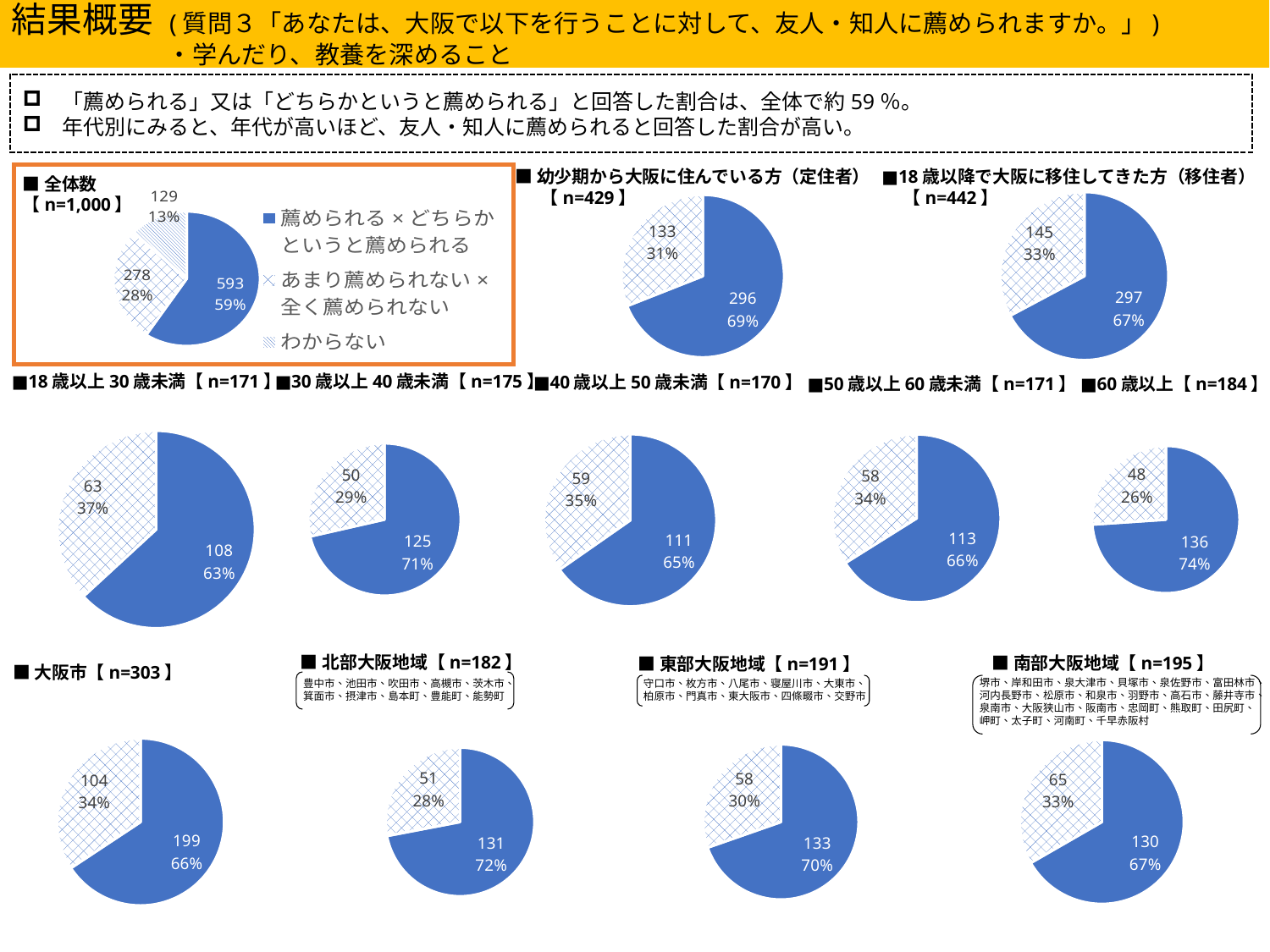
Which has a larger solid blue percentage: the 北部大阪地域【n=182】 pie chart or the 南部大阪地域【n=195】 pie chart? 北部大阪地域【n=182】 In the 30歳以上40歳未満【n=175】 pie chart, what is the count shown for the solid blue slice? 125 In the 全体数【n=1,000】 pie chart, what percentage share is shown for わからない? 13% What type of chart is used for the 全体数【n=1,000】 data? Pie chart Among the five age-group pie charts, which group shows the highest percentage for the solid blue slice? 60歳以上【n=184】 Among the five age-group pie charts, which group shows the lowest percentage for the solid blue slice? 18歳以上30歳未満【n=171】 In the 全体数【n=1,000】 pie chart, what is the count for 薦められる × どちらかというと薦められる? 593 In the 東部大阪地域【n=191】 pie chart, what percentage is shown for the hatched slice? 30% How many entries does the legend of the 全体数【n=1,000】 pie chart list? 3 In the 幼少期から大阪に住んでいる方（定住者）【n=429】 pie chart, what percentage is shown for the larger (solid blue) slice? 69% In the 18歳以降で大阪に移住してきた方（移住者）【n=442】 pie chart, what is the count shown for the smaller (hatched) slice? 145 What is the difference in count between the solid blue slice and the hatched slice in the 大阪市【n=303】 pie chart? 95